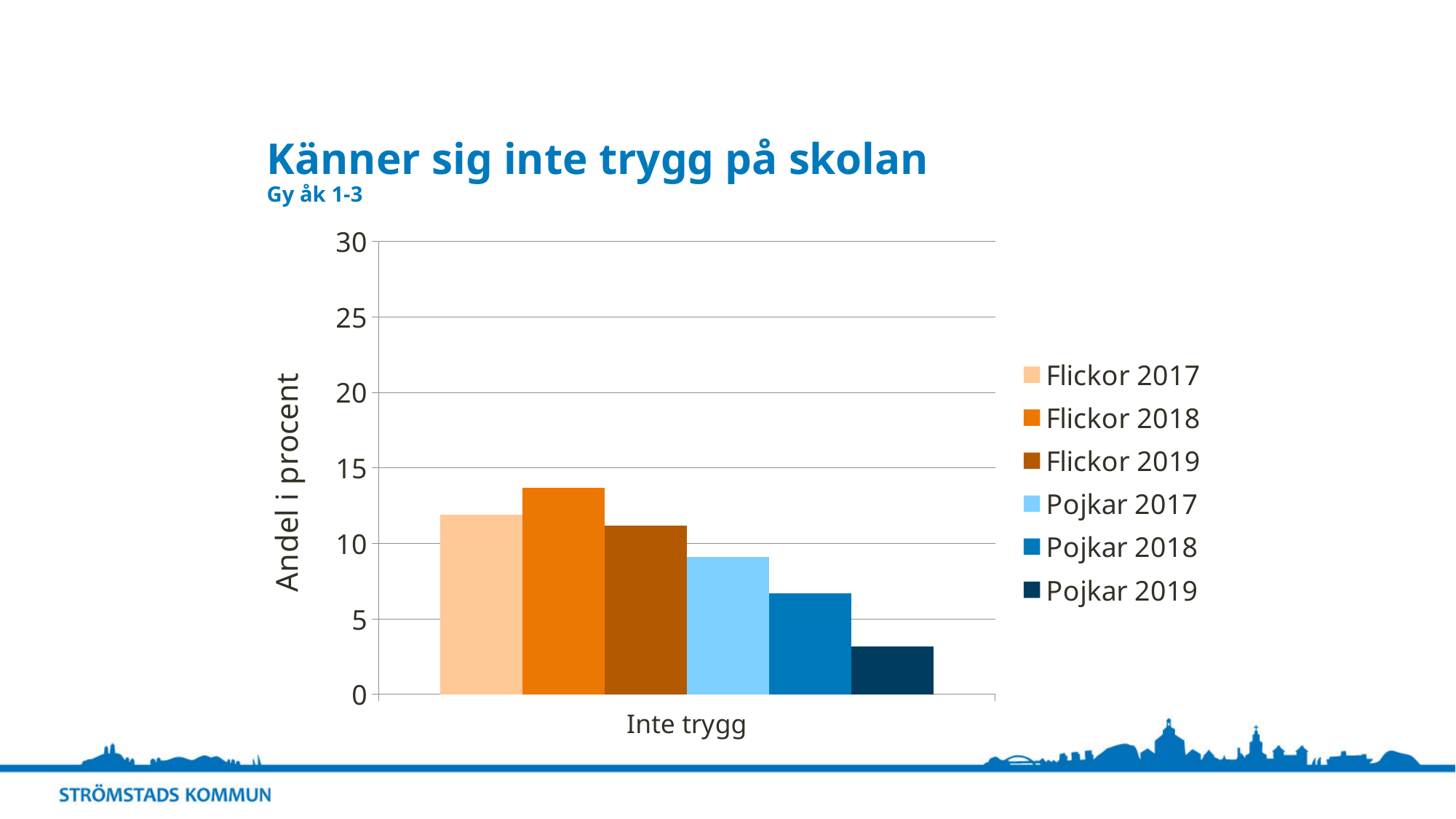
Which series has the highest value? Flickor 2018 Which is larger, the value for Flickor 2017 or the value for Pojkar 2017? Flickor 2017 What kind of chart is shown on the slide? bar chart Is the value for Pojkar 2017 greater or less than 10? less Is the value for Flickor 2018 greater or less than 10? greater Which series has the lowest value? Pojkar 2019 How many series does the legend list? 6 What is the title of the chart? Känner sig inte trygg på skolan Is the value for Pojkar 2019 greater or less than 5? less What is the label on the y axis? Andel i procent How many categories are shown on the x axis? 1 Which is larger, the value for Pojkar 2018 or the value for Pojkar 2019? Pojkar 2018